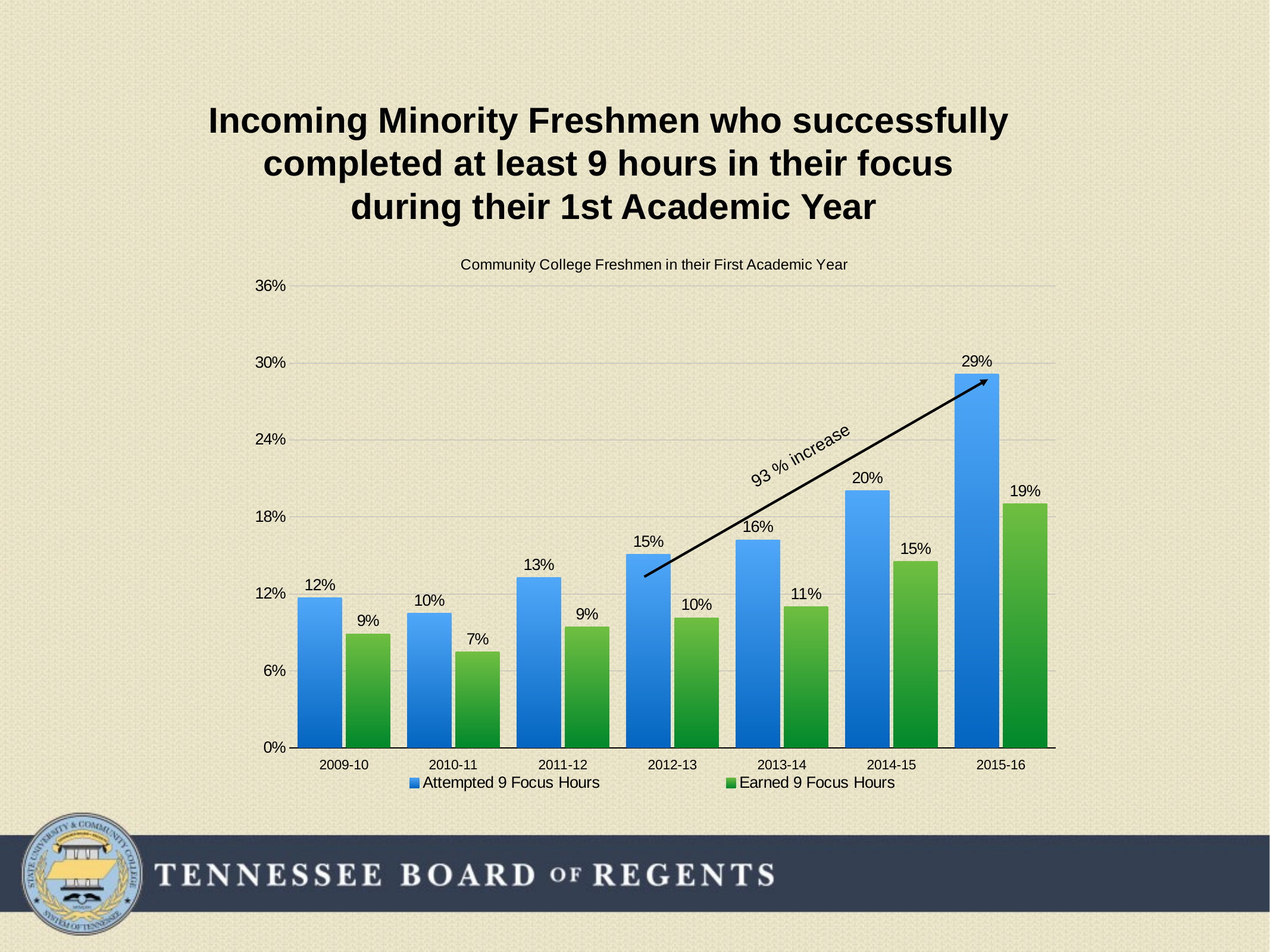
What is the value for Earned 9 Focus Hours in 2014-15? 15% Which year has the lowest value for Earned 9 Focus Hours? 2010-11 What is the difference between Attempted 9 Focus Hours and Earned 9 Focus Hours in 2015-16? 10% How many academic years are shown on the x axis? 7 What percentage increase is annotated by the arrow on the chart? 93 % increase What is the value for Attempted 9 Focus Hours in 2015-16? 29% What is the value for Earned 9 Focus Hours in 2010-11? 7% How many series does the legend list? 2 Is the value for Attempted 9 Focus Hours in 2014-15 greater or less than 18%? greater Which is larger: Attempted 9 Focus Hours in 2012-13 or Earned 9 Focus Hours in 2015-16? Earned 9 Focus Hours in 2015-16 Which year has the highest value for Attempted 9 Focus Hours? 2015-16 What kind of chart is shown on the slide? bar chart